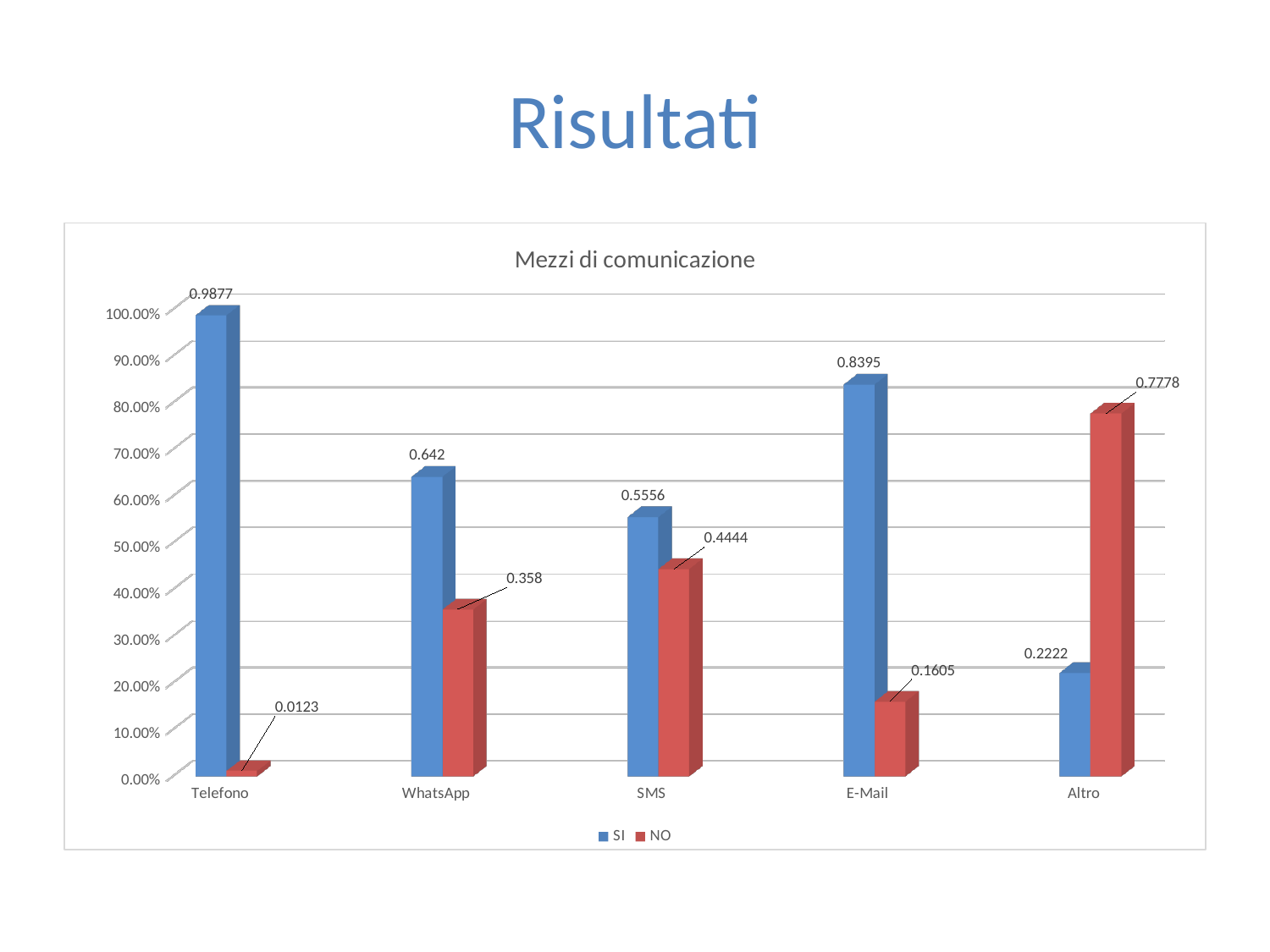
How many series does the legend list? 2 What is the NO value for Altro? 0.7778 What is the NO value for WhatsApp? 0.358 What is the difference between the SI and NO values for SMS? 0.1112 What type of chart is shown on the slide? Bar chart How many categories are shown on the x axis? 5 Which category has the highest SI value? Telefono What is the SI value for E-Mail? 0.8395 What is the SI value for Telefono in the Mezzi di comunicazione chart? 0.9877 Which category has the lowest NO value? Telefono Is the SI value for WhatsApp greater or less than 60.00%? greater For Altro, which is larger, the SI value or the NO value? NO